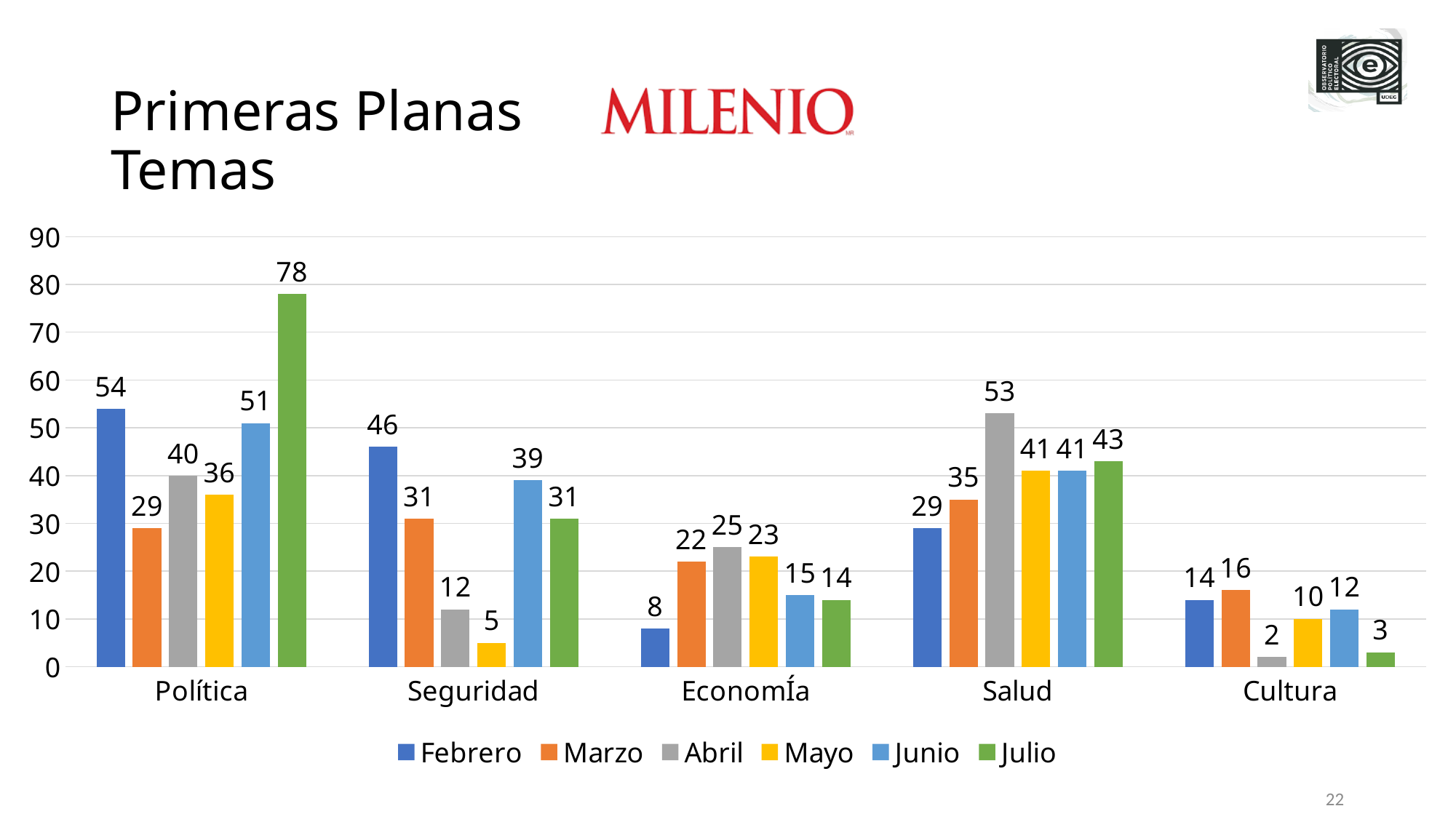
Which month has the lowest value in the Cultura category? Abril What is the value for Abril in the Salud category? 53 What kind of chart is shown on the slide? bar chart What is the value for Febrero in the Economía category? 8 Is the value for Junio in the Salud category greater or less than 30? greater How many series does the legend list? 6 Which month has the highest value in the Seguridad category? Febrero How many categories are shown on the x axis? 5 What colour are the Julio bars? green What is the value for Julio in the Política category? 78 What is the difference between the Julio and Febrero values in the Política category? 24 Which is larger: the Mayo value for Seguridad or the Mayo value for Economía? Economía